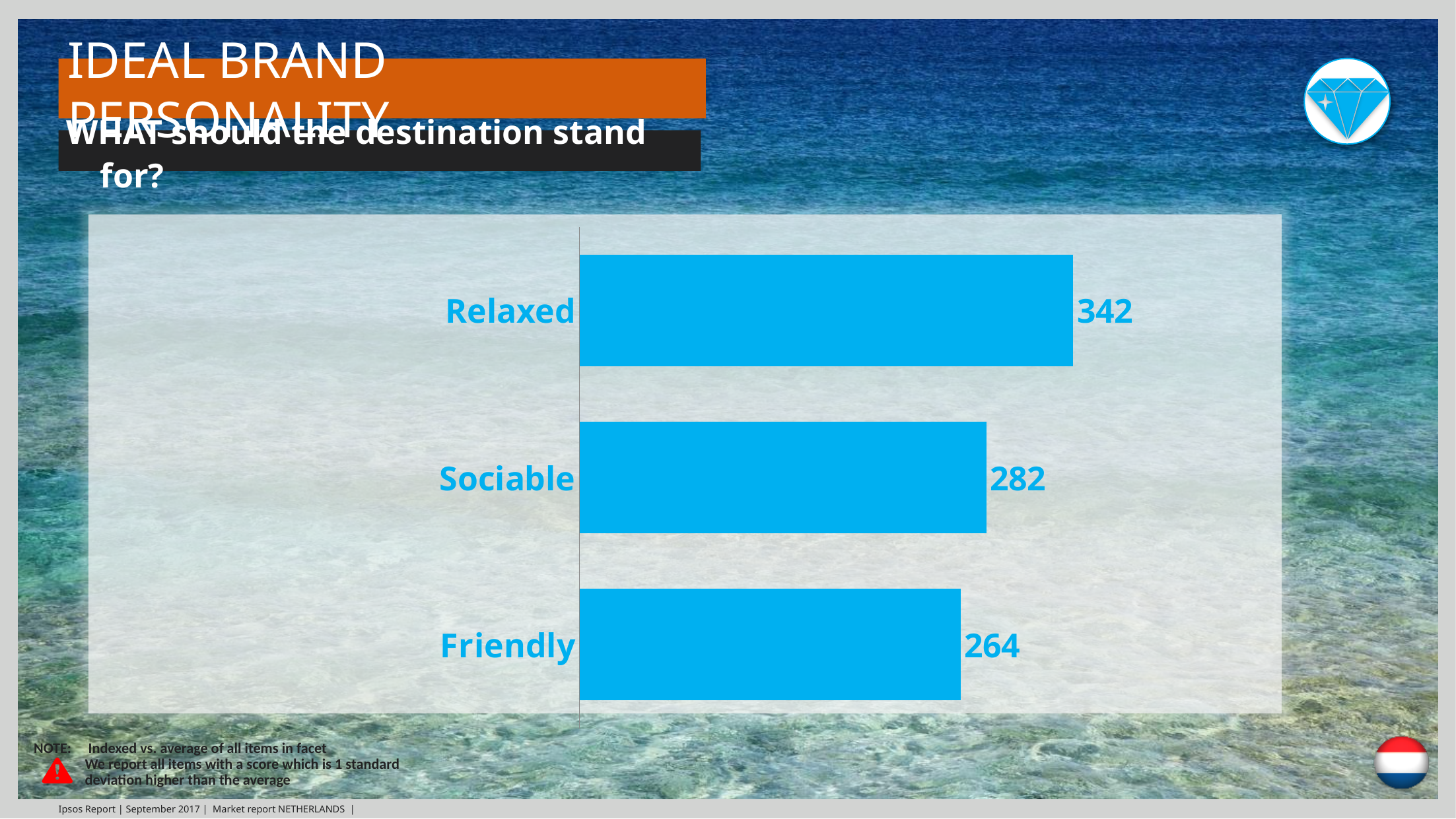
What colour are the bars in the chart? Blue What kind of chart is shown on the slide? Bar chart Which is larger, the value for Sociable or the value for Friendly? Sociable What is the value for Friendly? 264 What is the value for Sociable? 282 How many categories are shown in the chart? 3 What is the difference between the values for Sociable and Friendly? 18 Which category has the lowest value? Friendly What is the difference between the values for Relaxed and Sociable? 60 What is the difference between the values for Relaxed and Friendly? 78 What is the value for Relaxed? 342 Which category has the highest value? Relaxed